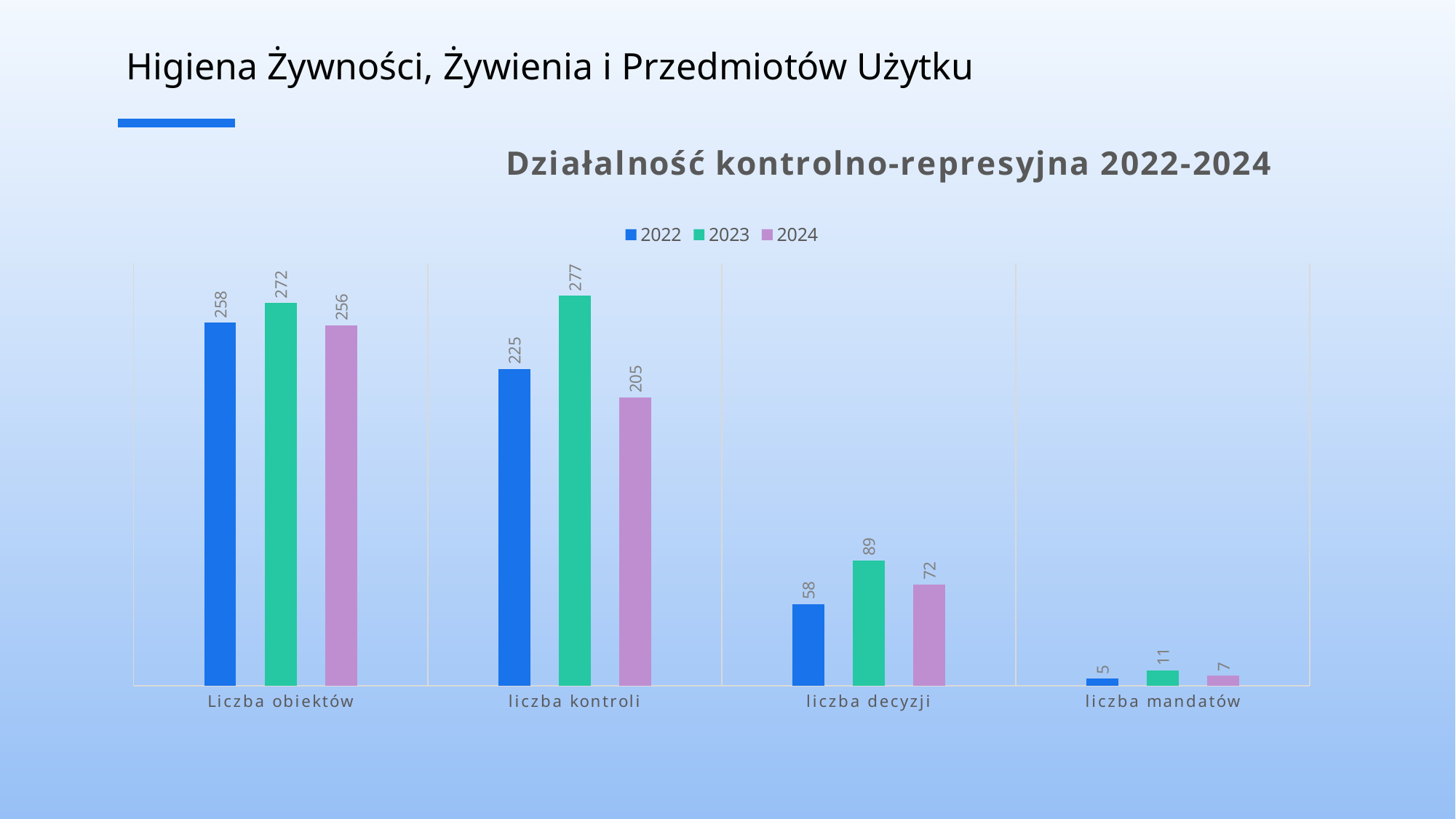
How many series does the legend list? 3 What is the value for 2023 in the 'liczba kontroli' category? 277 What is the difference between the 2023 and 2024 values for 'liczba mandatów'? 4 What is the value for 2024 in the 'liczba decyzji' category? 72 How many categories are shown on the x axis? 4 What is the value for 2022 in the 'Liczba obiektów' category? 258 What is the difference between the 2023 and 2022 values for 'liczba kontroli'? 52 What is the title of the chart? Działalność kontrolno-represyjna 2022-2024 Which year has the lowest value in the 'liczba mandatów' category? 2022 What kind of chart is shown on the slide? Bar chart Which year has the highest value in the 'liczba decyzji' category? 2023 Which is larger: the 2022 value or the 2024 value for 'Liczba obiektów'? 2022